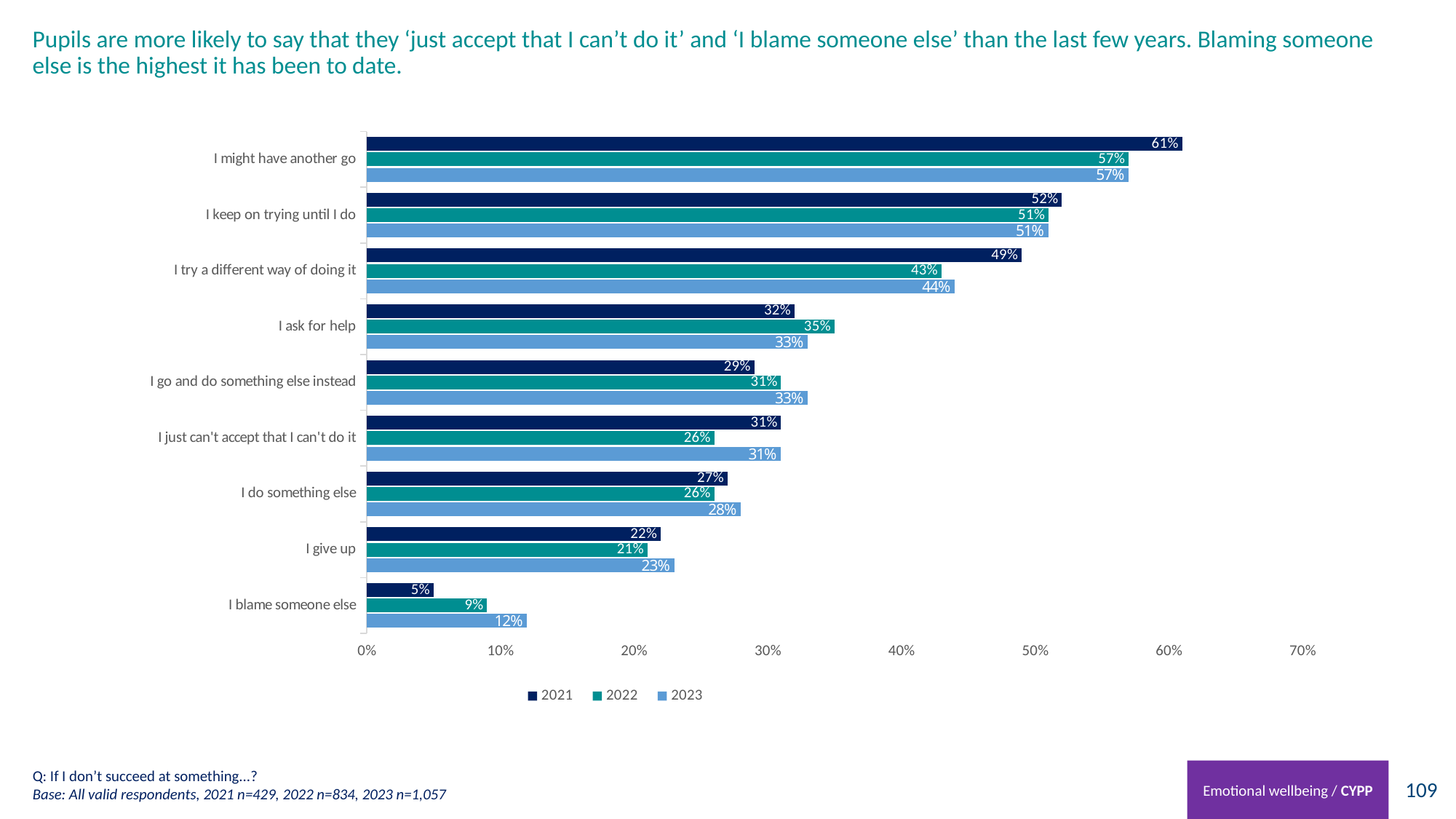
Which is larger for 'I just can't accept that I can't do it': the 2022 value or the 2023 value? 2023 How many categories are shown on the chart? 9 What is the 2022 value for 'I ask for help'? 35% What is the difference between the 2023 and 2021 values for 'I blame someone else'? 7% What is the difference between the 2021 and 2023 values for 'I try a different way of doing it'? 5% What is the 2021 value for 'I might have another go'? 61% What is the 2023 value for 'I blame someone else'? 12% What kind of chart is shown on the slide? Bar chart Which years are listed in the chart legend? 2021, 2022, 2023 How many series does the legend list? 3 Which category has the highest 2023 value? I might have another go Which category has the lowest 2021 value? I blame someone else